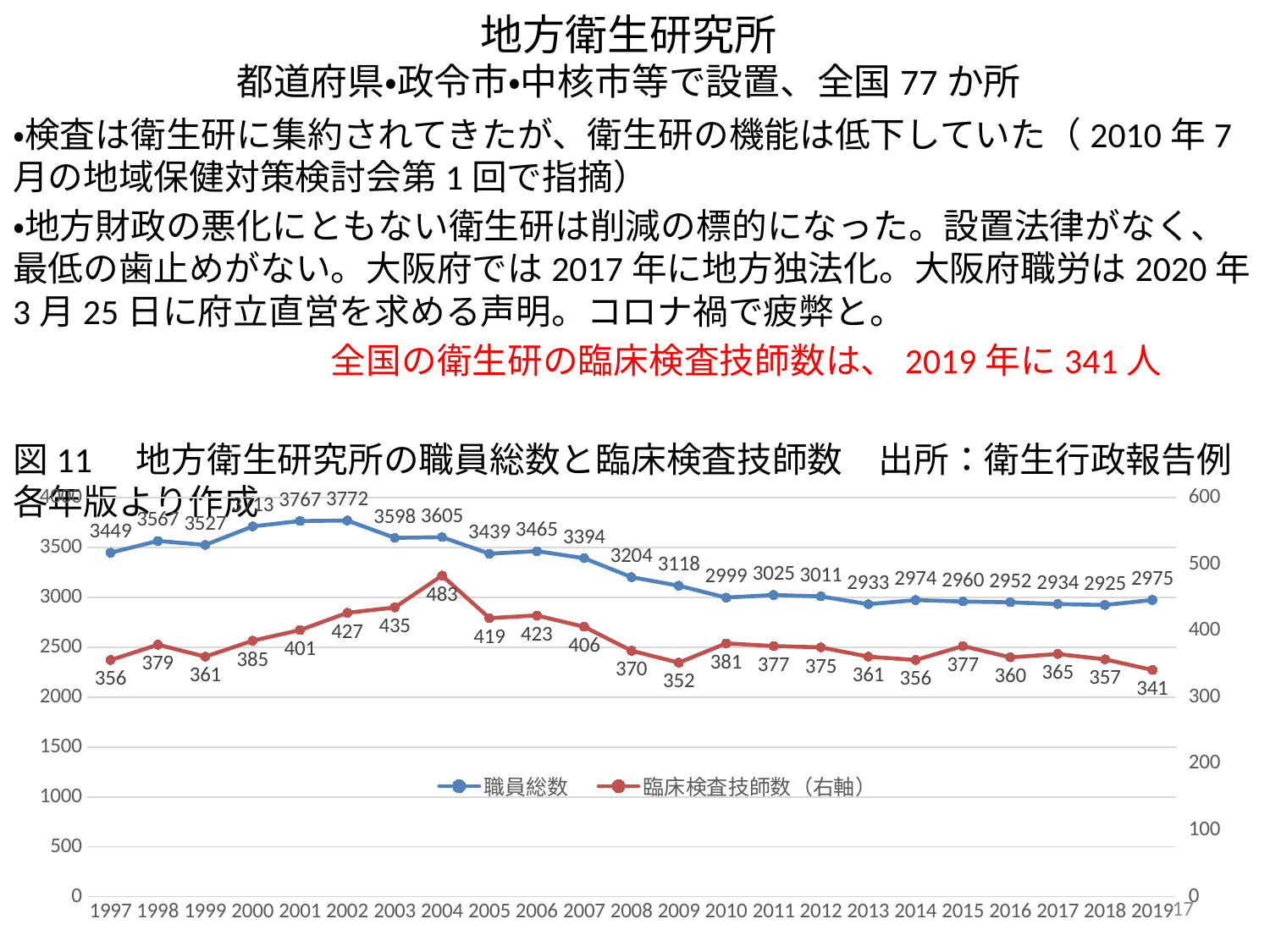
What is the value of 職員総数 in 2019? 2975 In which year does 臨床検査技師数 reach its lowest value? 2019 How many years are plotted along the x axis of the chart? 23 In which year does 臨床検査技師数 reach its highest value? 2004 What is the difference between 職員総数 in 2002 and in 2019? 797 What type of chart is shown on the slide? line chart What is the value of 職員総数 in 1997? 3449 Which is larger, 臨床検査技師数 in 2010 or in 2009? 2010 How many series does the chart legend list? 2 Overall, does 職員総数 rise or fall from 2002 to 2019? fall Which series is plotted on the right axis according to the legend? 臨床検査技師数（右軸） What is the value of 臨床検査技師数 in 2004? 483